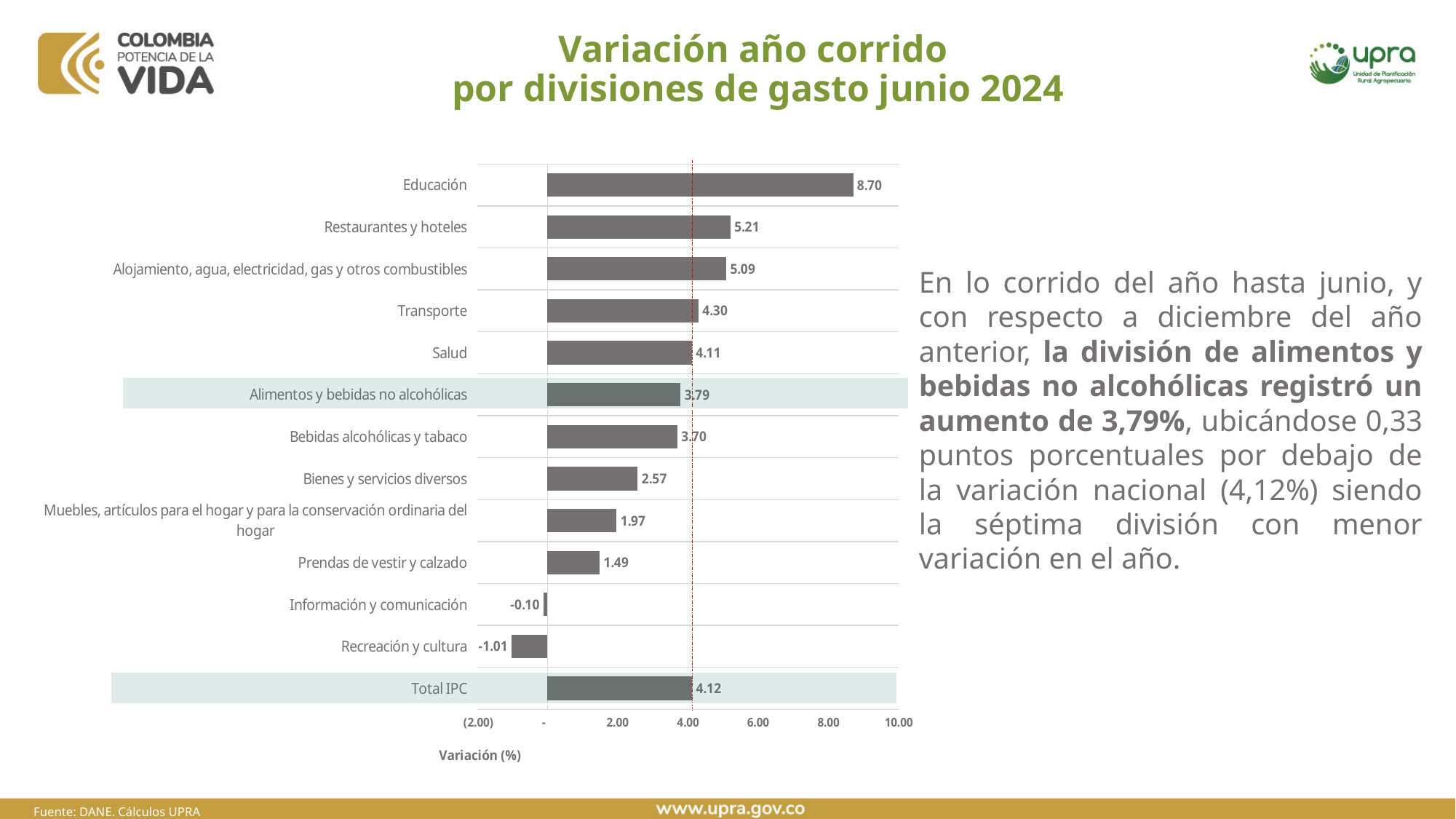
How many categories (bars) are shown in the chart? 13 Which division has the lowest variation? Recreación y cultura What is the value for Educación? 8.70 What is the value for Alimentos y bebidas no alcohólicas? 3.79 What is the value for Total IPC? 4.12 Which is larger, the value for Salud or the value for Bebidas alcohólicas y tabaco? Salud What is the difference between the values for Restaurantes y hoteles and Transporte? 0.91 Is the value for Bienes y servicios diversos greater or less than 4.00? less What is the value for Recreación y cultura? -1.01 What kind of chart is shown on the slide? Bar chart Which division has the highest variation? Educación What is the label of the horizontal axis? Variación (%)